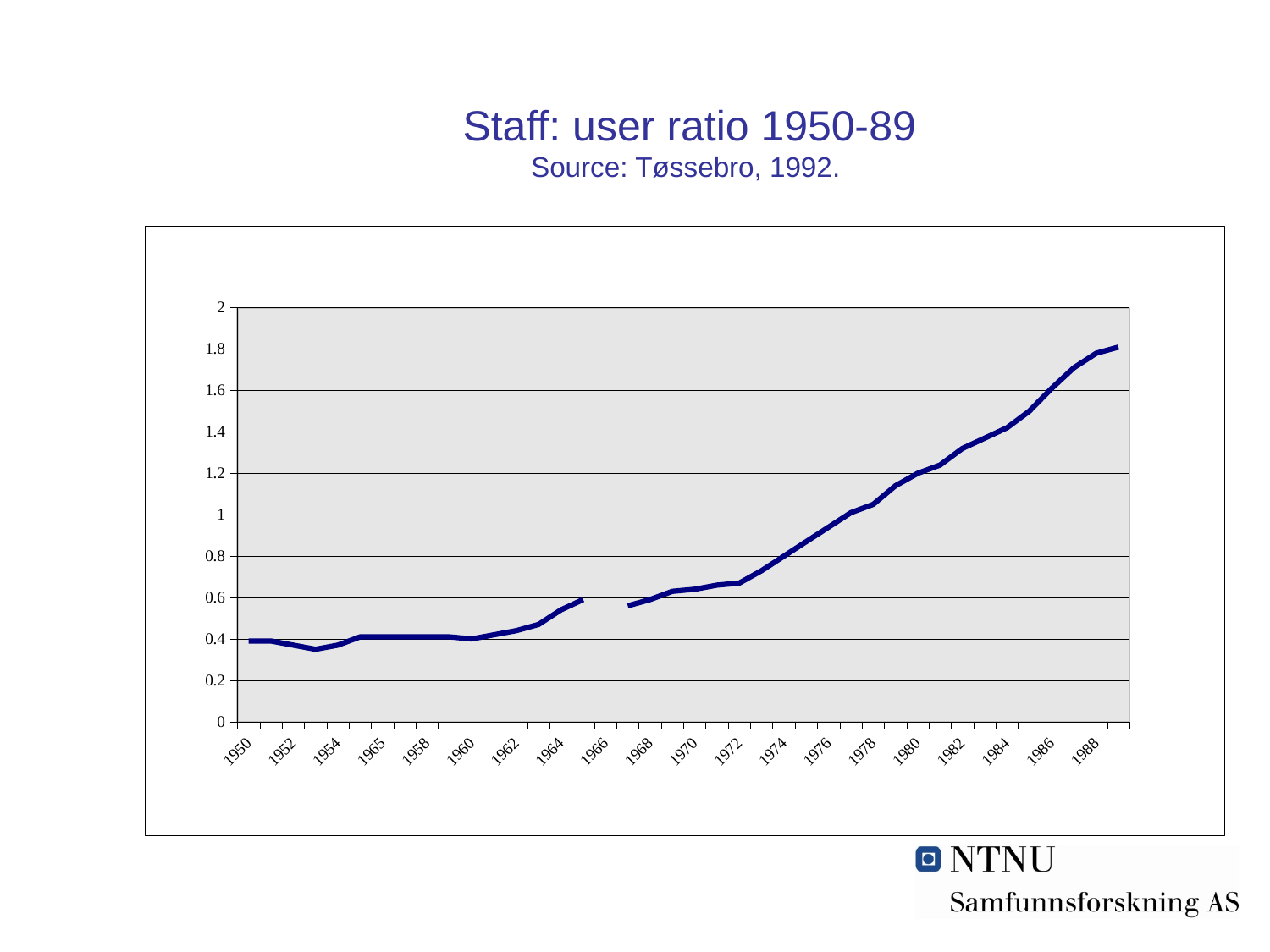
Is the value for 1984 greater or less than 1.2? greater In which part of the period does the line reach its highest value? the end (1988-89) Is the value for 1972 greater or less than 0.8? less Which is larger, the value for 1950 or the value for 1988? 1988 Is the value for 1950 greater or less than 0.6? less What kind of chart is shown on the slide? line chart What source is cited for the chart? Tøssebro, 1992. Does the staff: user ratio generally rise or fall from 1950 to 1989? rise What is the title of the chart? Staff: user ratio 1950-89